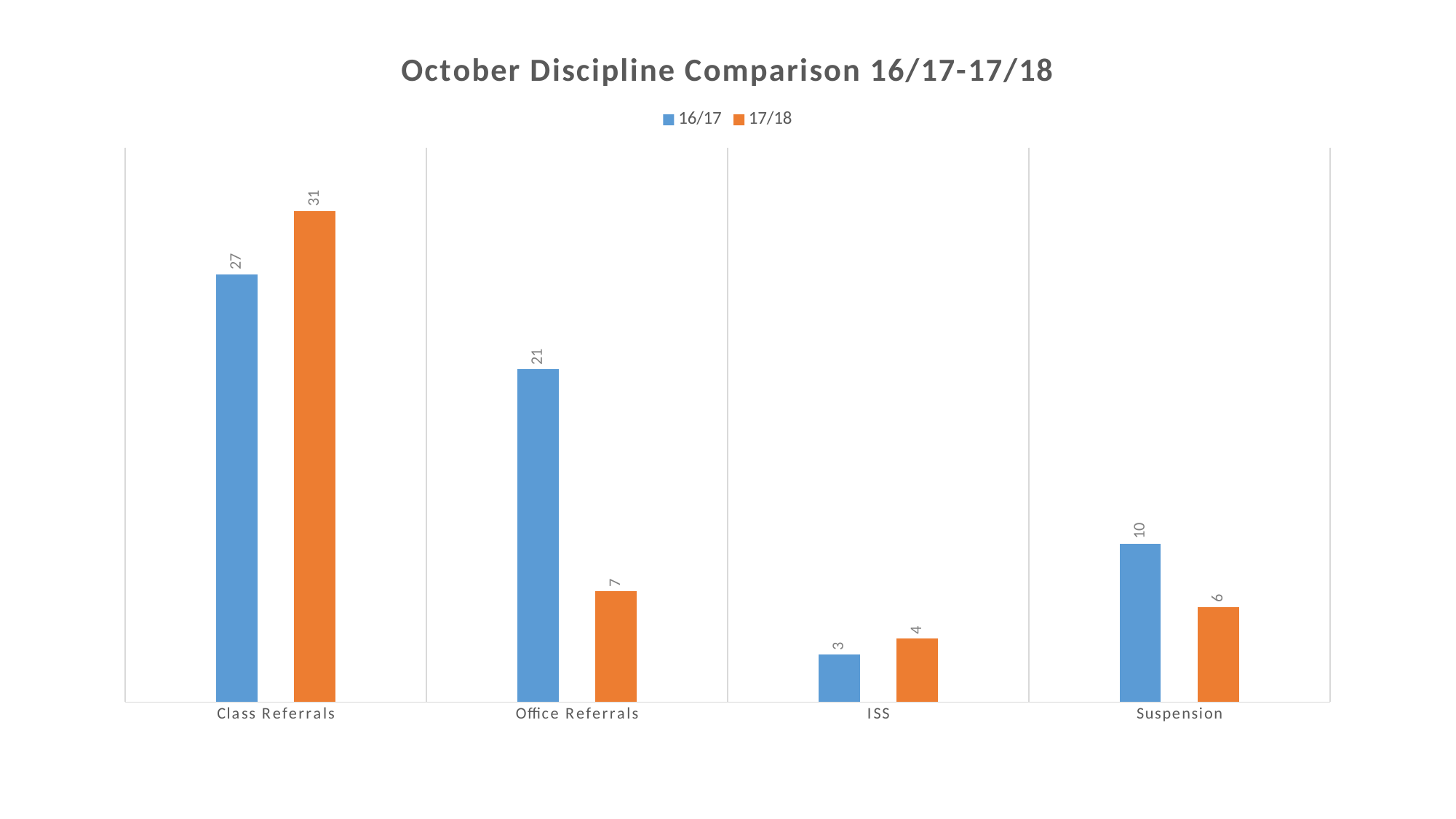
What is the title of the chart? October Discipline Comparison 16/17-17/18 What is the 16/17 value for ISS? 3 What kind of chart is shown on the slide? Bar chart Which category has the highest 17/18 value? Class Referrals What is the 17/18 value for Office Referrals? 7 What is the difference between the 16/17 and 17/18 values for Office Referrals? 14 How many series does the legend list? 2 Which is larger for Suspension, the 16/17 value or the 17/18 value? 16/17 What is the 16/17 value for Class Referrals? 27 How many categories are shown on the x axis? 4 Which category has the lowest 16/17 value? ISS What is the 17/18 value for Suspension? 6